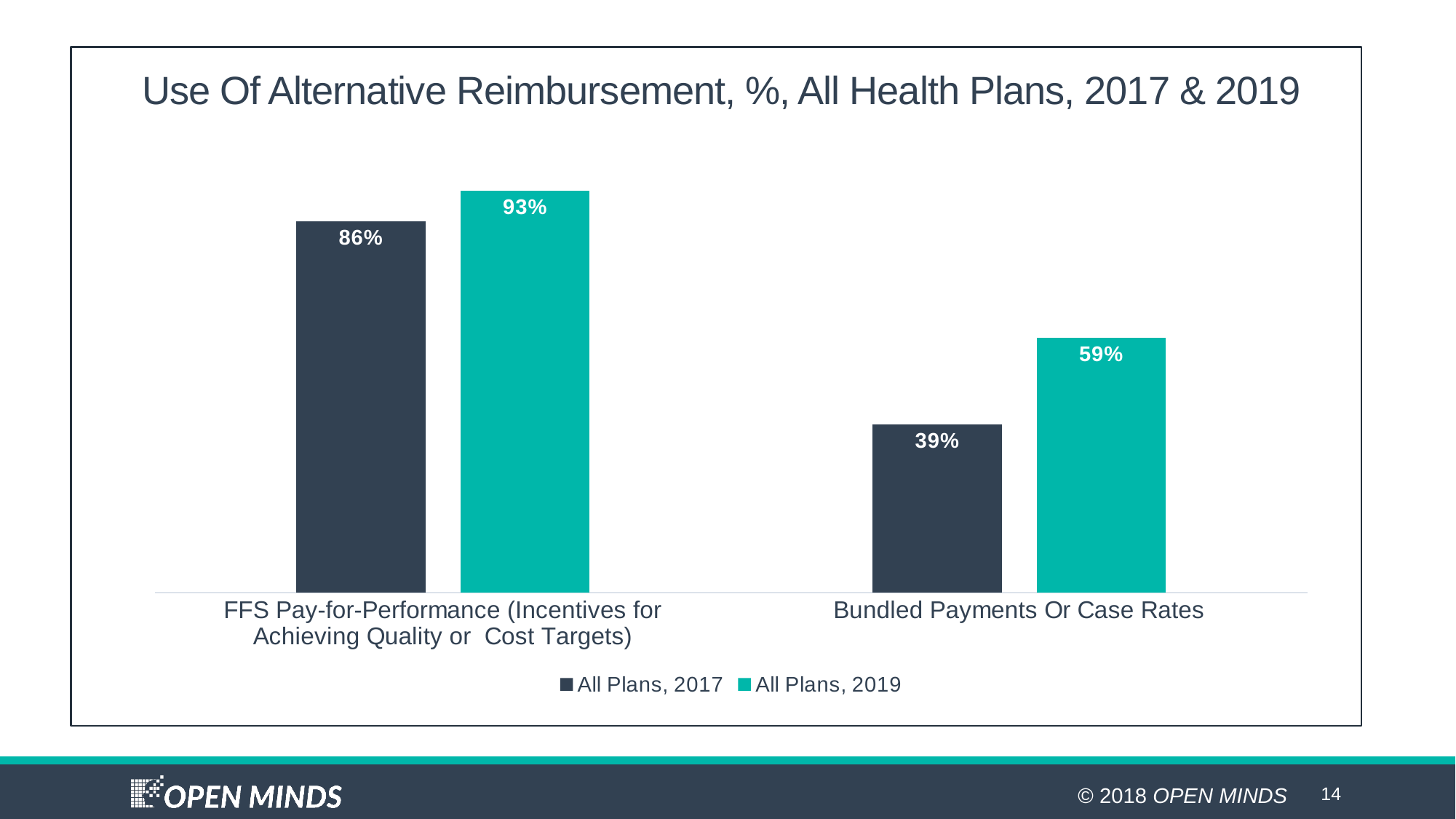
What is the value for Bundled Payments Or Case Rates for All Plans, 2017? 39% Which is larger for Bundled Payments Or Case Rates: All Plans, 2017 or All Plans, 2019? All Plans, 2019 What is the value for FFS Pay-for-Performance for All Plans, 2017? 86% What is the value for FFS Pay-for-Performance for All Plans, 2019? 93% Which category has the lowest value for All Plans, 2017? Bundled Payments Or Case Rates How many categories are shown on the x axis? 2 What is the difference between the 2019 and 2017 values for Bundled Payments Or Case Rates? 20% What is the value for Bundled Payments Or Case Rates for All Plans, 2019? 59% How many series does the legend list? 2 What kind of chart is shown on the slide? Bar chart What is the difference between the 2019 and 2017 values for FFS Pay-for-Performance? 7% Which category has the highest value for All Plans, 2019? FFS Pay-for-Performance (Incentives for Achieving Quality or Cost Targets)